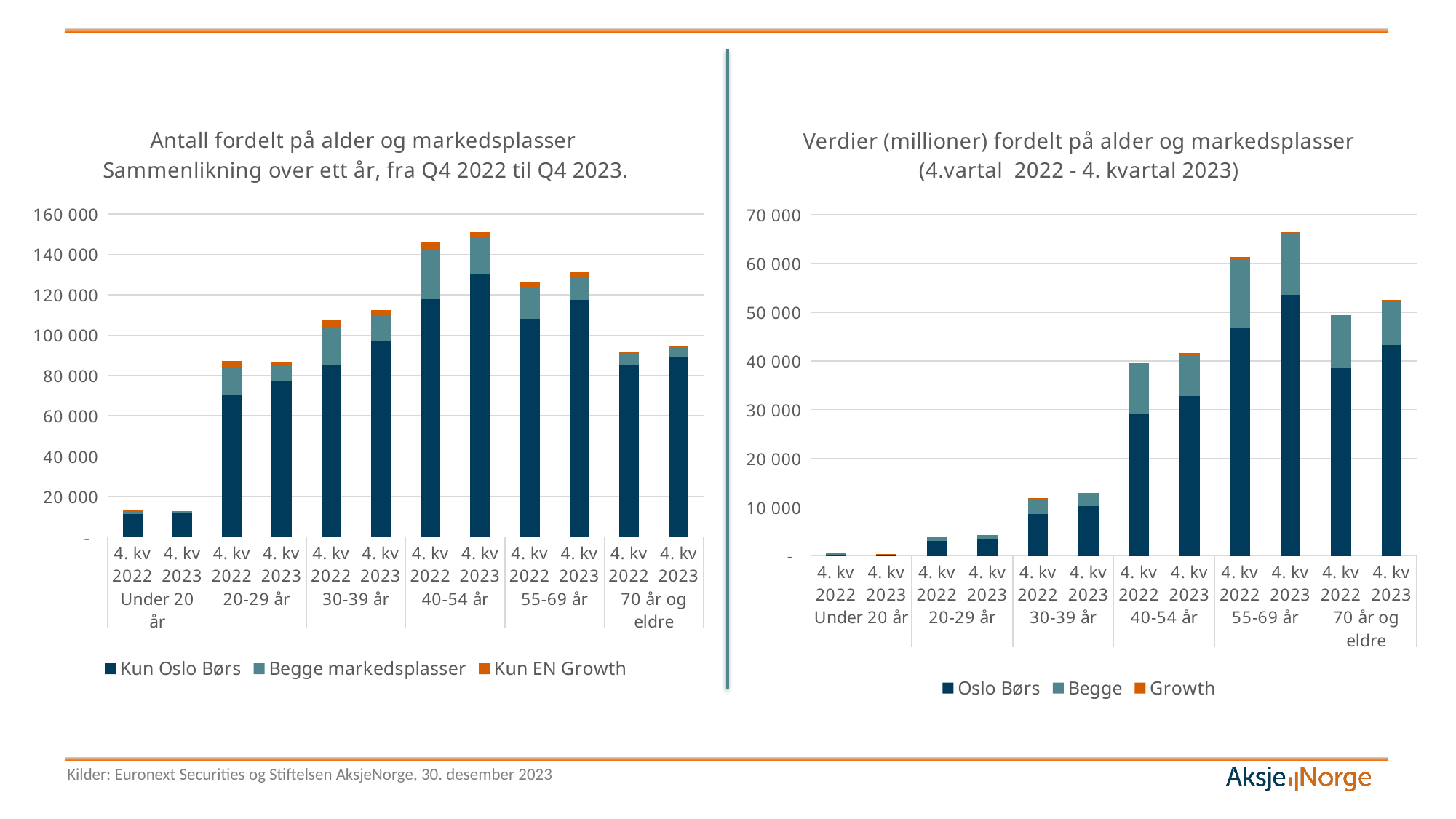
On the left chart (Antall fordelt på alder og markedsplasser), which series is shown in orange? Kun EN Growth On the left chart (Antall fordelt på alder og markedsplasser), what kind of chart is shown? Stacked bar chart On the right chart (Verdier (millioner) fordelt på alder og markedsplasser), which bar has the highest total? 4. kv 2023, 55-69 år On the left chart (Antall fordelt på alder og markedsplasser), is the total for 4. kv 2022 in the Under 20 år group greater or less than 20 000? less On the left chart (Antall fordelt på alder og markedsplasser), how many bars are plotted? 12 On the left chart (Antall fordelt på alder og markedsplasser), which is larger: the total for 4. kv 2023 in 55-69 år or the total for 4. kv 2023 in 70 år og eldre? 4. kv 2023 in 55-69 år On the left chart (Antall fordelt på alder og markedsplasser), which bar has the highest total? 4. kv 2023, 40-54 år On the right chart (Verdier (millioner) fordelt på alder og markedsplasser), is the total for 4. kv 2023 in the 70 år og eldre group greater or less than 50 000? greater On the right chart (Verdier (millioner) fordelt på alder og markedsplasser), what are the three legend entries? Oslo Børs, Begge, Growth On the right chart (Verdier (millioner) fordelt på alder og markedsplasser), which is larger: the total for 4. kv 2023 in 40-54 år or the total for 4. kv 2022 in 55-69 år? 4. kv 2022 in 55-69 år On the left chart (Antall fordelt på alder og markedsplasser), how many series does the legend list? 3 On the left chart (Antall fordelt på alder og markedsplasser), is the total for 4. kv 2023 in the 40-54 år group greater or less than 140 000? greater